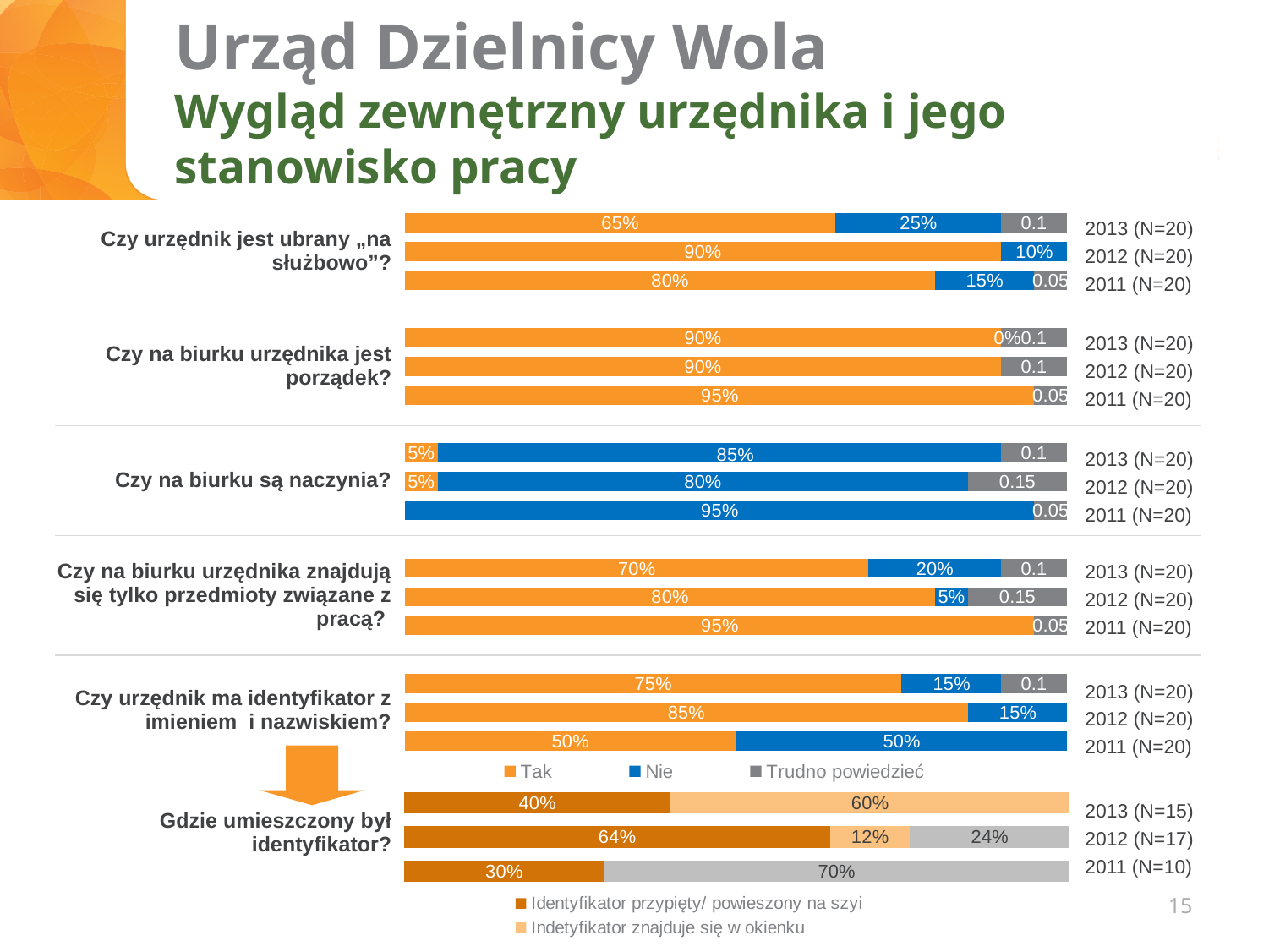
In the chart "Czy urzędnik jest ubrany „na służbowo”?", what is the "Nie" value for 2011 (N=20)? 15% In the chart "Czy na biurku urzędnika znajdują się tylko przedmioty związane z pracą?", what is the difference between the "Tak" values for 2011 (N=20) and 2013 (N=20)? 25% In the chart "Czy na biurku urzędnika jest porządek?", what is the "Tak" value for 2011 (N=20)? 95% In the chart "Czy na biurku są naczynia?", which year has the lowest "Nie" value? 2012 (N=20) In the chart "Czy na biurku są naczynia?", what is the "Nie" value for 2013 (N=20)? 85% In the chart "Czy urzędnik ma identyfikator z imieniem i nazwiskiem?", is the "Tak" value for 2012 (N=20) larger than the "Tak" value for 2011 (N=20)? Yes, 2012 (85%) is larger than 2011 (50%) In the chart "Czy urzędnik jest ubrany „na służbowo”?", which year has the highest "Tak" value? 2012 (N=20) What type of chart is used for "Czy na biurku urzędnika jest porządek?"? Stacked bar chart In the chart "Czy urzędnik ma identyfikator z imieniem i nazwiskiem?", what is the "Nie" value for 2013 (N=20)? 15% In the chart "Gdzie umieszczony był identyfikator?", what is the value for "Identyfikator przypięty/ powieszony na szyi" in 2012 (N=17)? 64% In the chart "Czy urzędnik jest ubrany „na służbowo”?", what is the "Tak" value for 2013 (N=20)? 65% In the chart "Gdzie umieszczony był identyfikator?", how many years (bars) are shown? 3